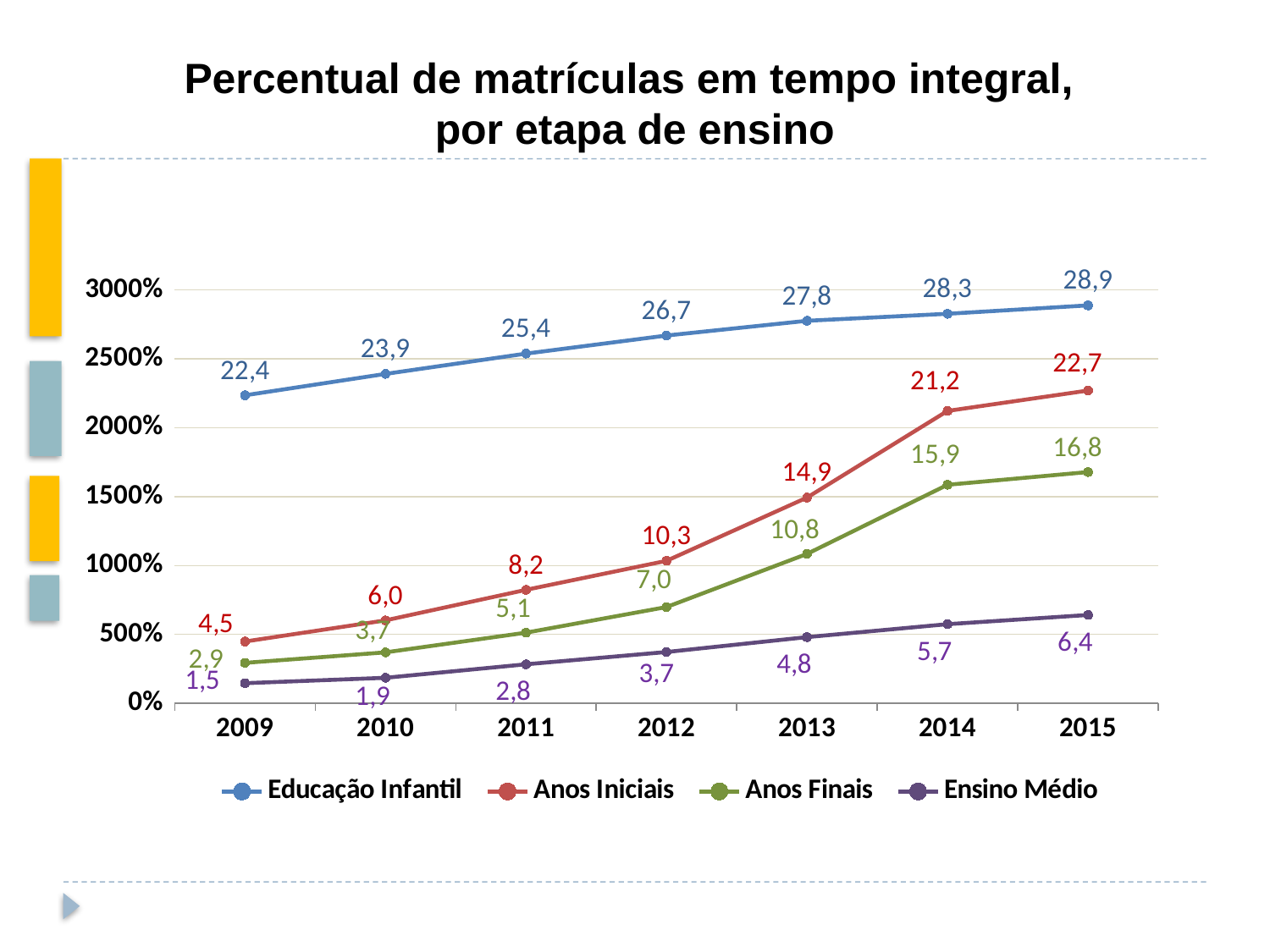
Which series has the highest value in 2015? Educação Infantil What is the difference between the Anos Iniciais values in 2014 and 2013? 6,3 How many series does the legend list? 4 Which series has the lowest value in 2011? Ensino Médio What is the value for Ensino Médio in 2009? 1,5 What kind of chart is shown on the slide? Line chart Does the Ensino Médio series rise or fall from 2009 to 2015? Rise How many years are shown on the x axis? 7 Which is larger: Anos Finais in 2014 or Anos Iniciais in 2012? Anos Finais in 2014 What is the value for Anos Iniciais in 2013? 14,9 What is the value for Anos Finais in 2012? 7,0 What is the value for Educação Infantil in 2015? 28,9